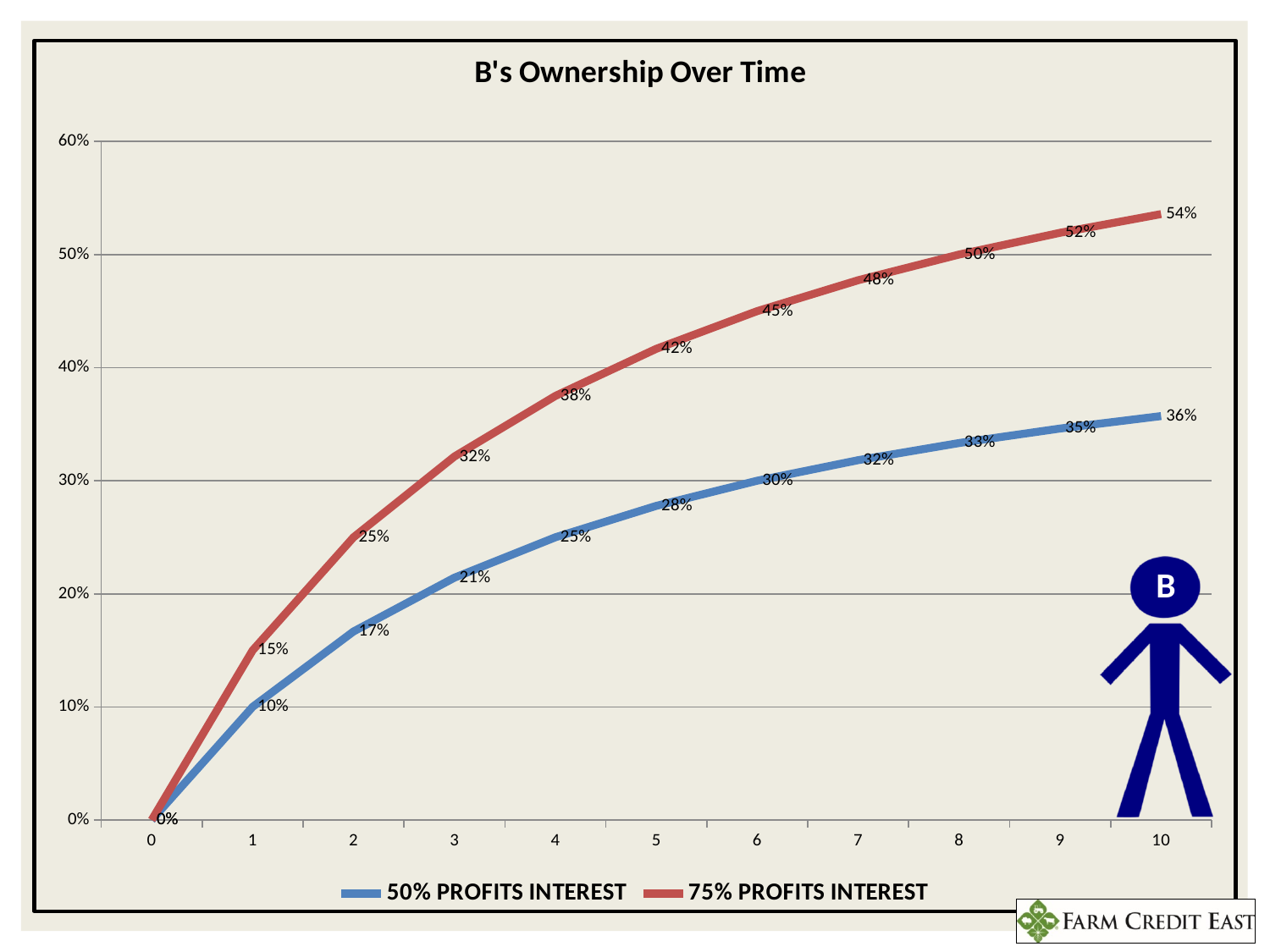
What is the value of the 50% PROFITS INTEREST series at year 1? 10% How many series does the legend list? 2 What is the title of the chart? B's Ownership Over Time At which year does the 50% PROFITS INTEREST series reach its highest value? 10 What is the value of the 50% PROFITS INTEREST series at year 3? 21% Which series has the higher value at year 6, 50% PROFITS INTEREST or 75% PROFITS INTEREST? 75% PROFITS INTEREST Do the values of the 75% PROFITS INTEREST series rise or fall from year 0 to year 10? rise What is the difference between the 75% PROFITS INTEREST values at year 2 and year 1? 10% What is the value of the 75% PROFITS INTEREST series at year 10? 54% What kind of chart is shown on the slide? line chart What is the difference between the 75% PROFITS INTEREST and 50% PROFITS INTEREST values at year 10? 18% What is the value of the 75% PROFITS INTEREST series at year 5? 42%